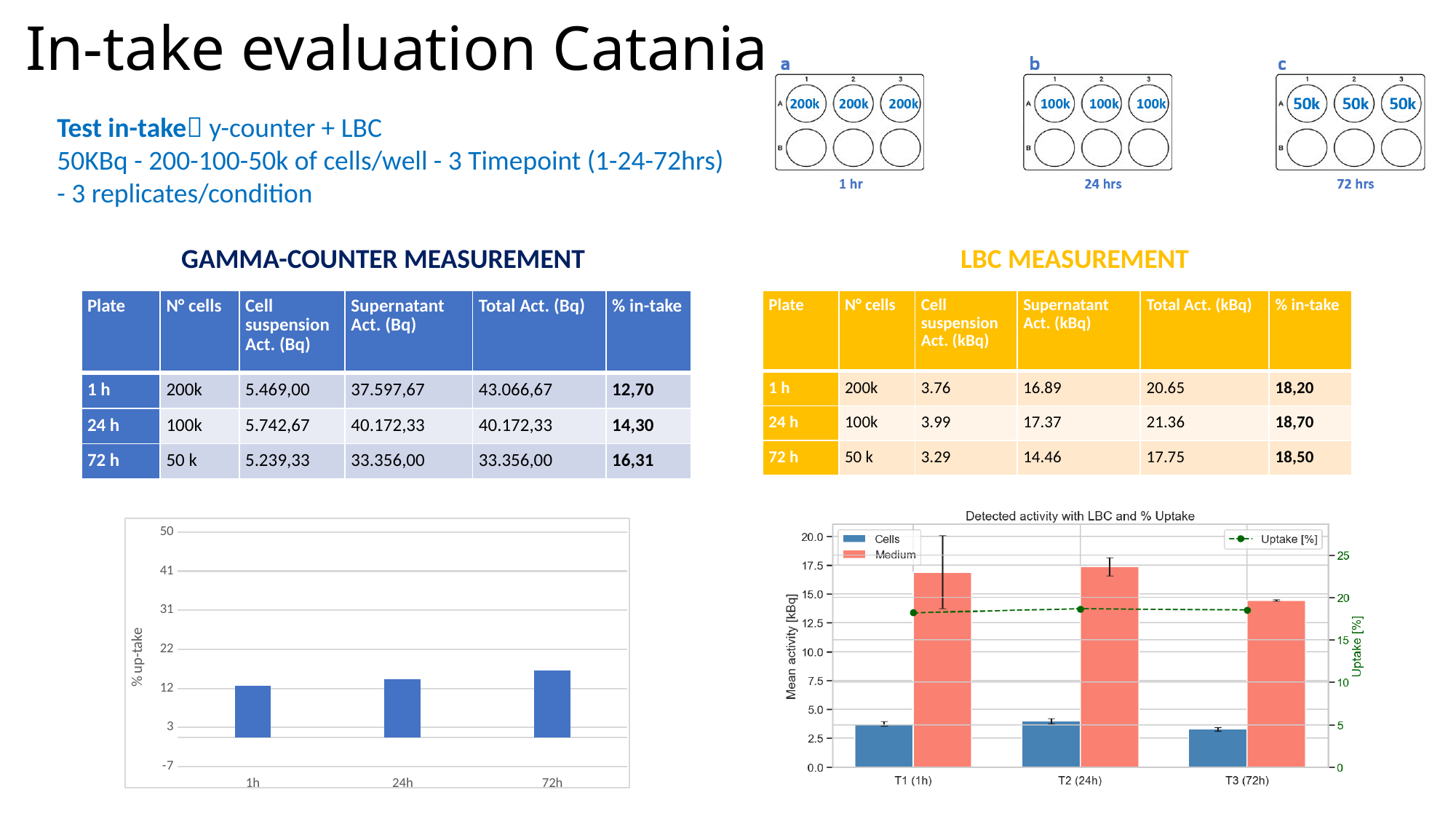
In the chart on the right (Detected activity with LBC and % Uptake), is the Cells value at T3 (72h) greater or less than 5.0 kBq? less What kind of chart is the chart on the left side of the slide (% up-take)? bar chart In the chart on the left (% up-take), is the value for 72h greater or less than 22? less In the chart on the right (Detected activity with LBC and % Uptake), is the Medium value at T1 (1h) greater or less than 15.0 kBq? greater In the chart on the left (% up-take), do the values rise or fall from 1h to 72h? rise What is the title of the chart on the right side of the slide? Detected activity with LBC and % Uptake In the chart on the left (% up-take), how many bars are shown? 3 In the chart on the right (Detected activity with LBC and % Uptake), which is larger at T2 (24h): Cells or Medium? Medium In the chart on the right (Detected activity with LBC and % Uptake), how many series does the legend list in total? 3 In the chart on the right (Detected activity with LBC and % Uptake), at which time point is the Medium bar lowest? T3 (72h) In the chart on the right (Detected activity with LBC and % Uptake), how many time-point categories are shown on the x axis? 3